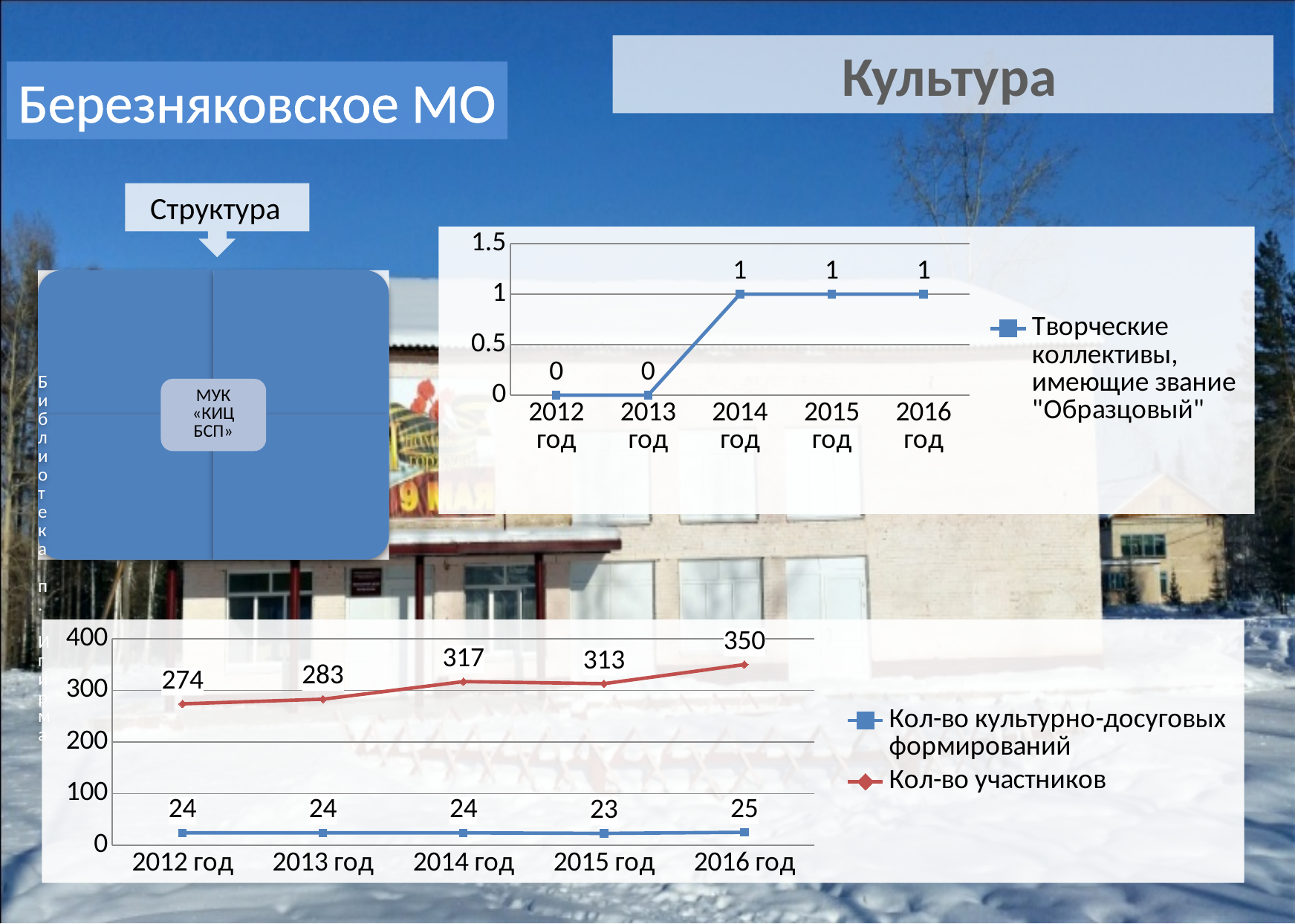
In the bottom chart, which year has the lowest value of Кол-во участников? 2012 год In the bottom chart, which year has the highest value of Кол-во участников? 2016 год In the top-right chart, what is the value for 2014 год? 1 In the bottom chart, does Кол-во участников generally rise or fall from 2012 год to 2016 год? rise What kind of chart is the top-right chart? line chart In the bottom chart, what is the difference between Кол-во участников in 2016 год and 2012 год? 76 In the top-right chart, what is the value for 2013 год? 0 How many series does the legend of the bottom chart list? 2 In the bottom chart, is Кол-во участников for 2014 год larger or smaller than for 2015 год? larger In the bottom chart, what is the value of Кол-во участников for 2016 год? 350 In the bottom chart, what is the value of Кол-во культурно-досуговых формирований for 2015 год? 23 How many years are plotted on the x axis of the top-right chart? 5